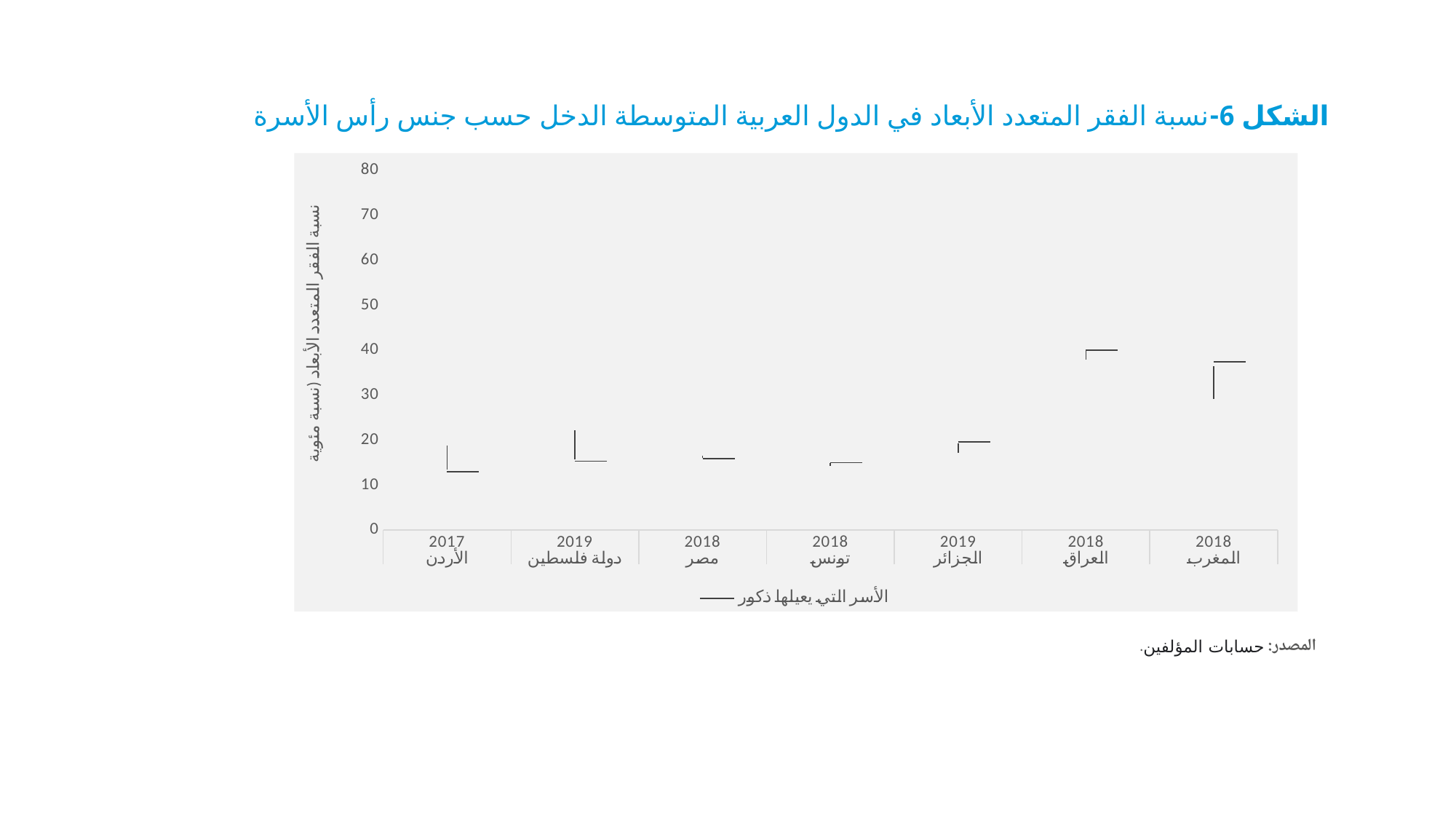
Is the value for مصر greater or less than 20? less Is the value for المغرب greater or less than 40? less Is the value for المغرب greater or less than 30? greater Which has the larger value, العراق or الأردن? العراق What is the series name shown in the chart legend? الأسر التي يعيلها ذكور Which has the larger value, المغرب or تونس? المغرب Which country has the highest multidimensional poverty rate in the chart? العراق How many countries are shown on the x axis of the chart? 7 What is the title of the chart on the slide? الشكل 6- نسبة الفقر المتعدد الأبعاد في الدول العربية المتوسطة الدخل حسب جنس رأس الأسرة How many series does the chart legend list? 1